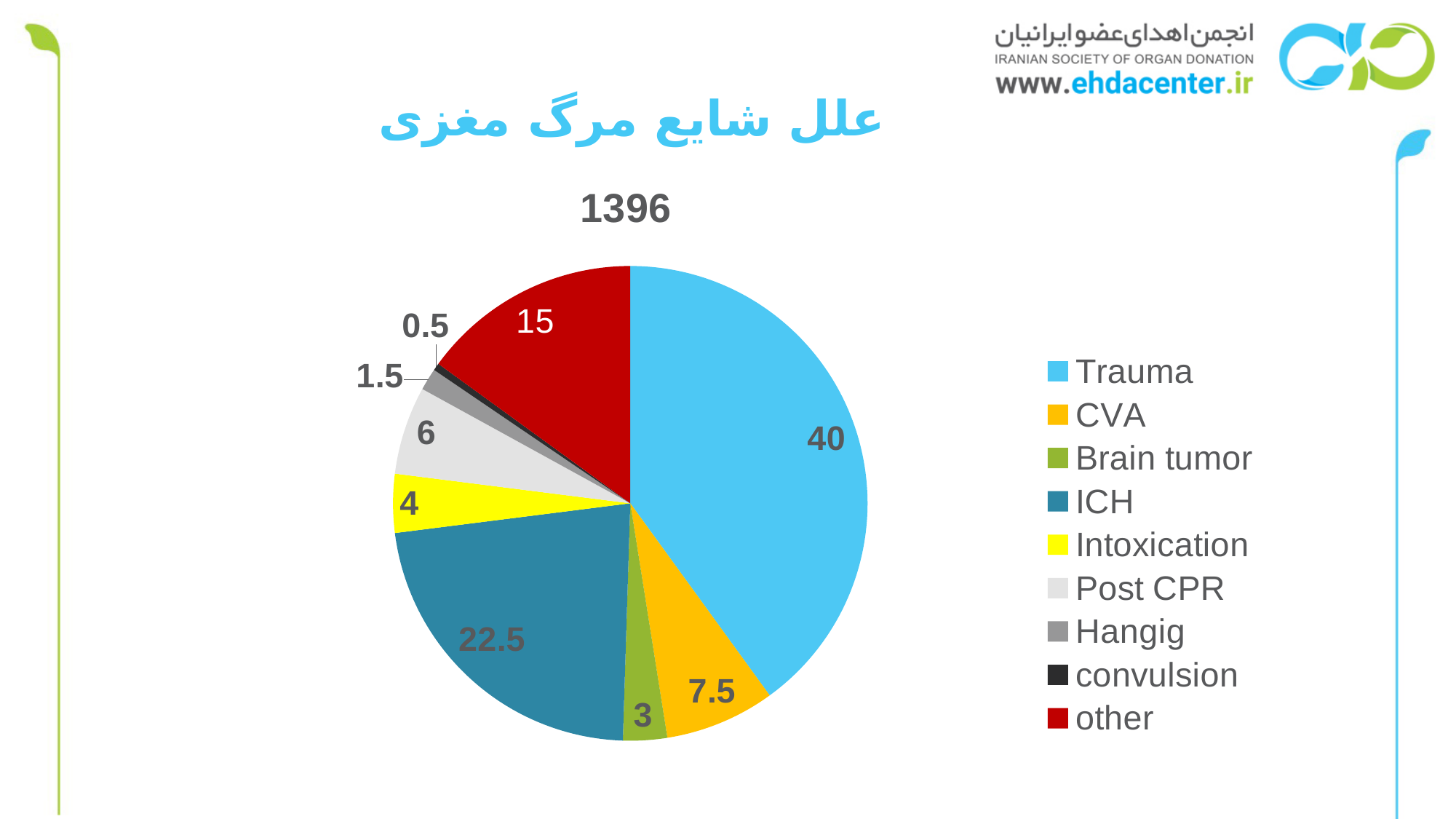
What value is shown for the Post CPR slice? 6 How many categories does the legend list? 9 What is the title shown above the pie chart? 1396 What is the difference between the values for Trauma and ICH? 17.5 What value is shown for the ICH slice? 22.5 What share of the pie does the Trauma slice represent? 40 What kind of chart is shown on the slide? Pie chart Which is larger, the value for other or the value for CVA? other What value is shown for the Trauma slice? 40 Which category has the largest slice of the pie? Trauma What value is shown for the CVA slice? 7.5 Which category has the smallest slice of the pie? convulsion